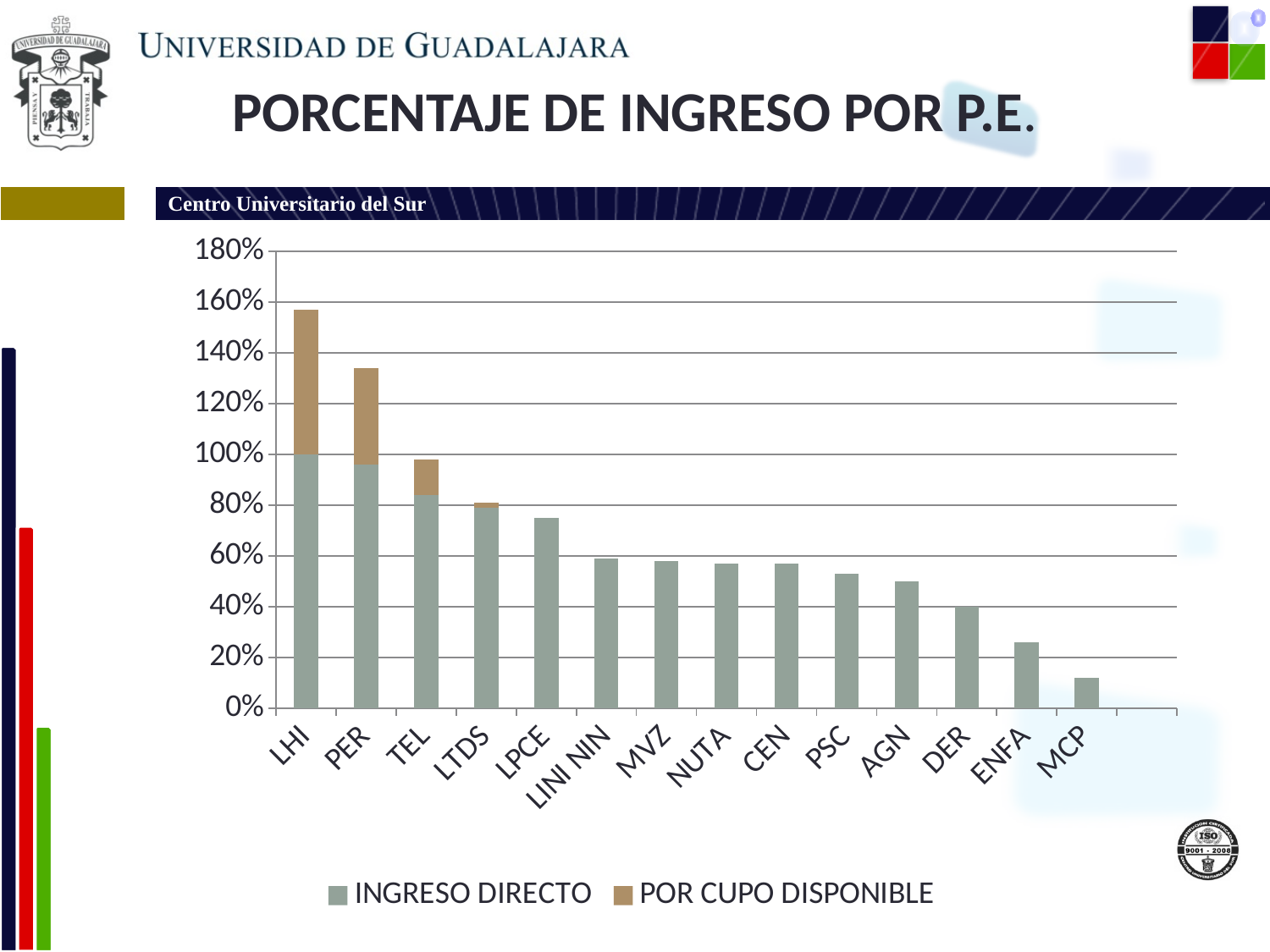
What kind of chart is shown on the slide? stacked bar chart Is the value for MCP greater or less than 20%? less Do the total bar values rise or fall from left to right along the x axis? fall Which category has the lowest total bar? MCP Is the total value for LHI greater or less than 140%? greater Is the value for LPCE greater or less than 60%? greater How many categories are shown on the x axis of the chart? 14 Which category has the highest total bar? LHI Which has a larger total bar, TEL or LPCE? TEL How many series does the legend list? 2 Which series is shown in the brown colour in the legend? POR CUPO DISPONIBLE